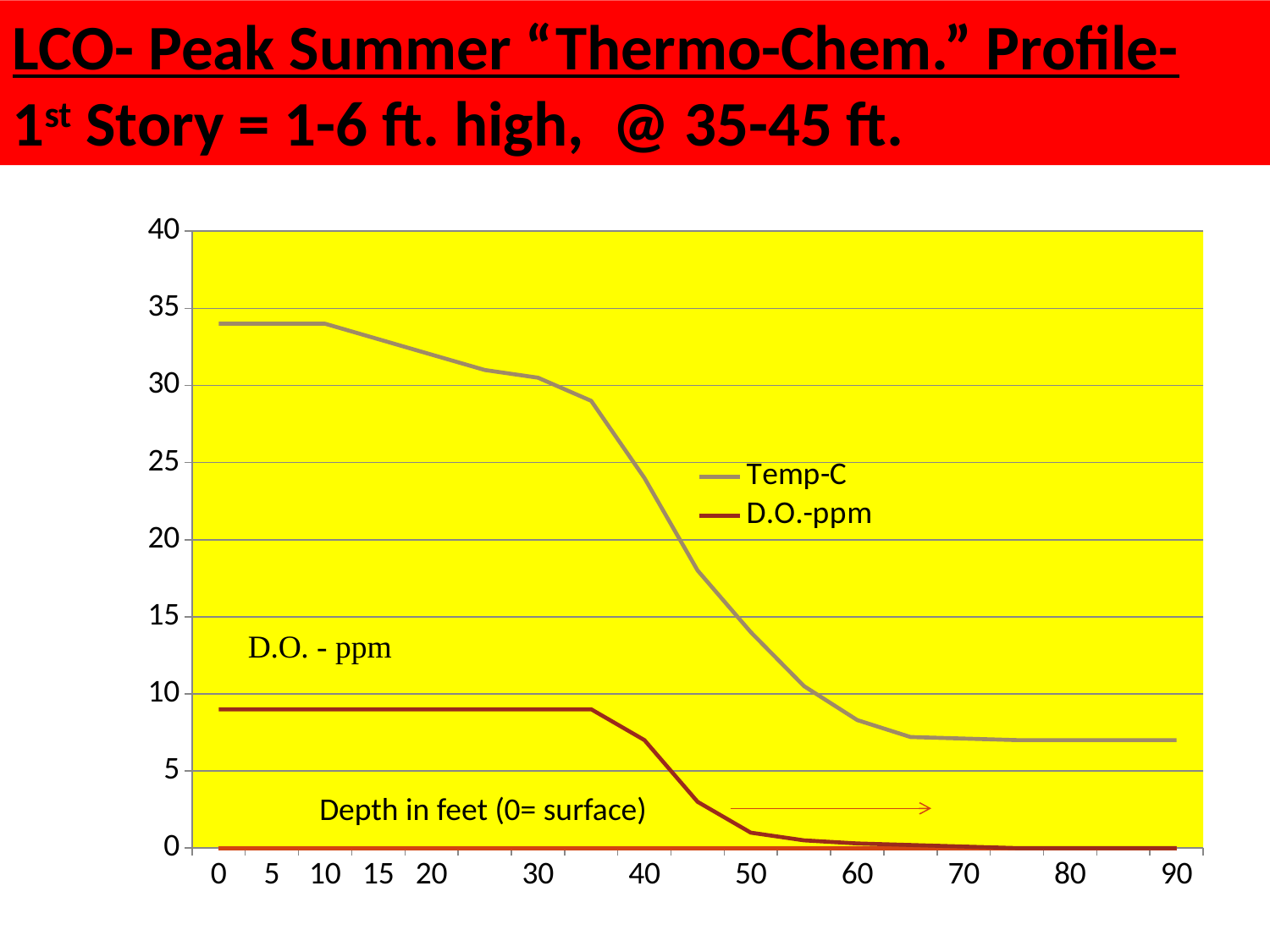
Is the D.O.-ppm value at depth 0 greater or less than 10? less Is the Temp-C value at depth 90 greater or less than 10? less Is the Temp-C value at depth 50 greater or less than 10? greater Does the Temp-C line rise or fall as depth increases from 0 to 90 feet? fall What kind of chart is shown on the slide? line chart What are the two series named in the legend? Temp-C and D.O.-ppm How many series does the legend list? 2 At depth 0, which series has the larger value, Temp-C or D.O.-ppm? Temp-C What does the x axis represent, according to the label inside the chart? Depth in feet (0= surface)